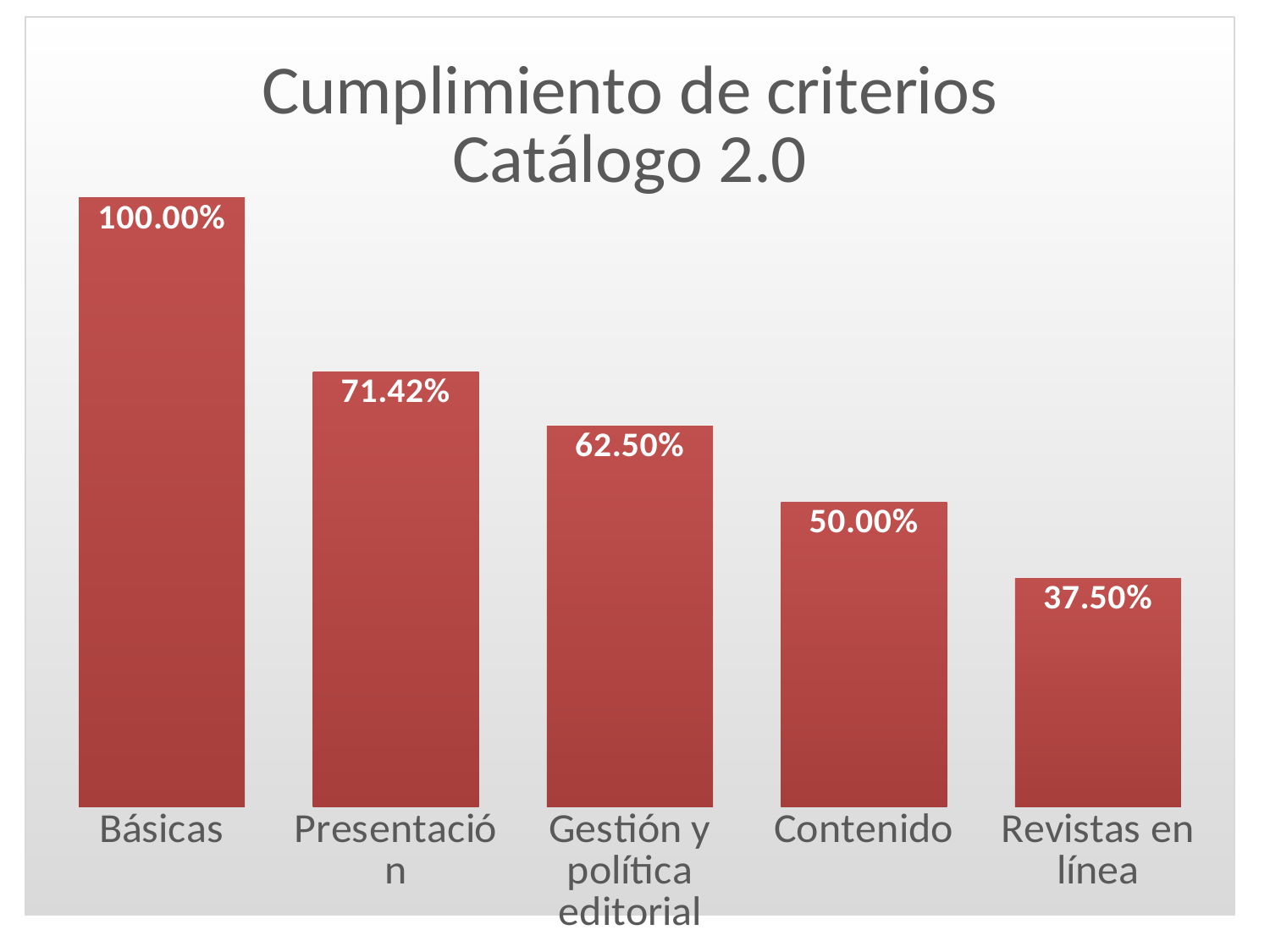
Which is larger, the value for Presentación or the value for Gestión y política editorial? Presentación What is the value for Básicas? 100.00% How many categories are shown in the chart? 5 What is the value for Presentación? 71.42% What is the difference between the values for Contenido and Revistas en línea? 12.50% Which category has the highest value? Básicas Do the values rise or fall from left to right along the x axis? Fall What is the value for Revistas en línea? 37.50% What is the value for Gestión y política editorial? 62.50% What kind of chart is this? Bar chart Which category has the lowest value? Revistas en línea What is the difference between the values for Básicas and Contenido? 50.00%